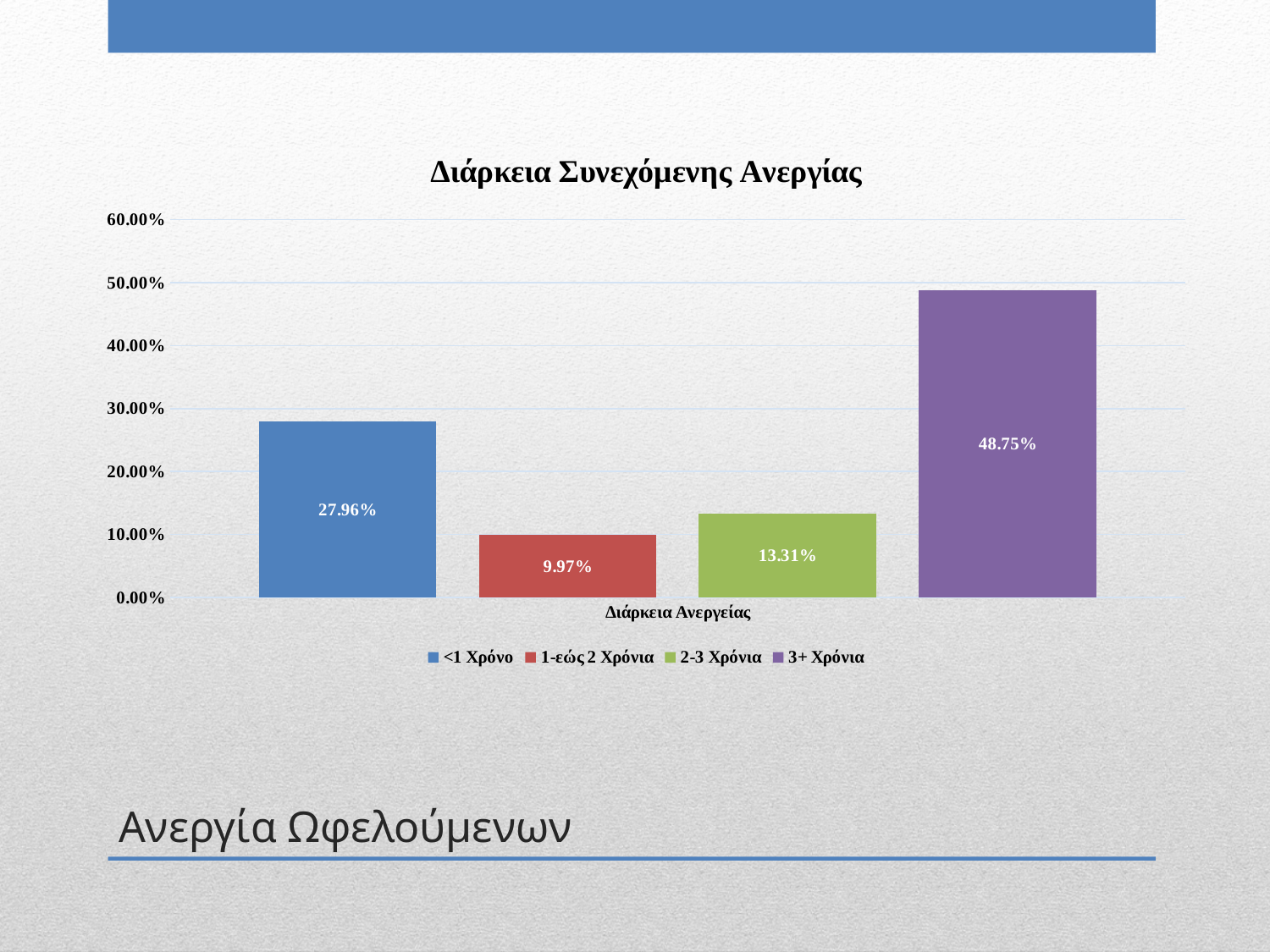
Which is larger, the value for 2-3 Χρόνια or the value for 1-εώς 2 Χρόνια? 2-3 Χρόνια What is the value for <1 Χρόνο? 27.96% How many series does the legend list? 4 Which category has the lowest value? 1-εώς 2 Χρόνια What is the value for 1-εώς 2 Χρόνια? 9.97% What is the value for 3+ Χρόνια? 48.75% Is the value for 3+ Χρόνια greater or less than 40.00%? greater What is the value for 2-3 Χρόνια? 13.31% What kind of chart is shown on the slide? bar chart What is the difference between the values for 3+ Χρόνια and <1 Χρόνο? 20.79% Which category has the highest value? 3+ Χρόνια What is the title of the chart? Διάρκεια Συνεχόμενης Ανεργίας